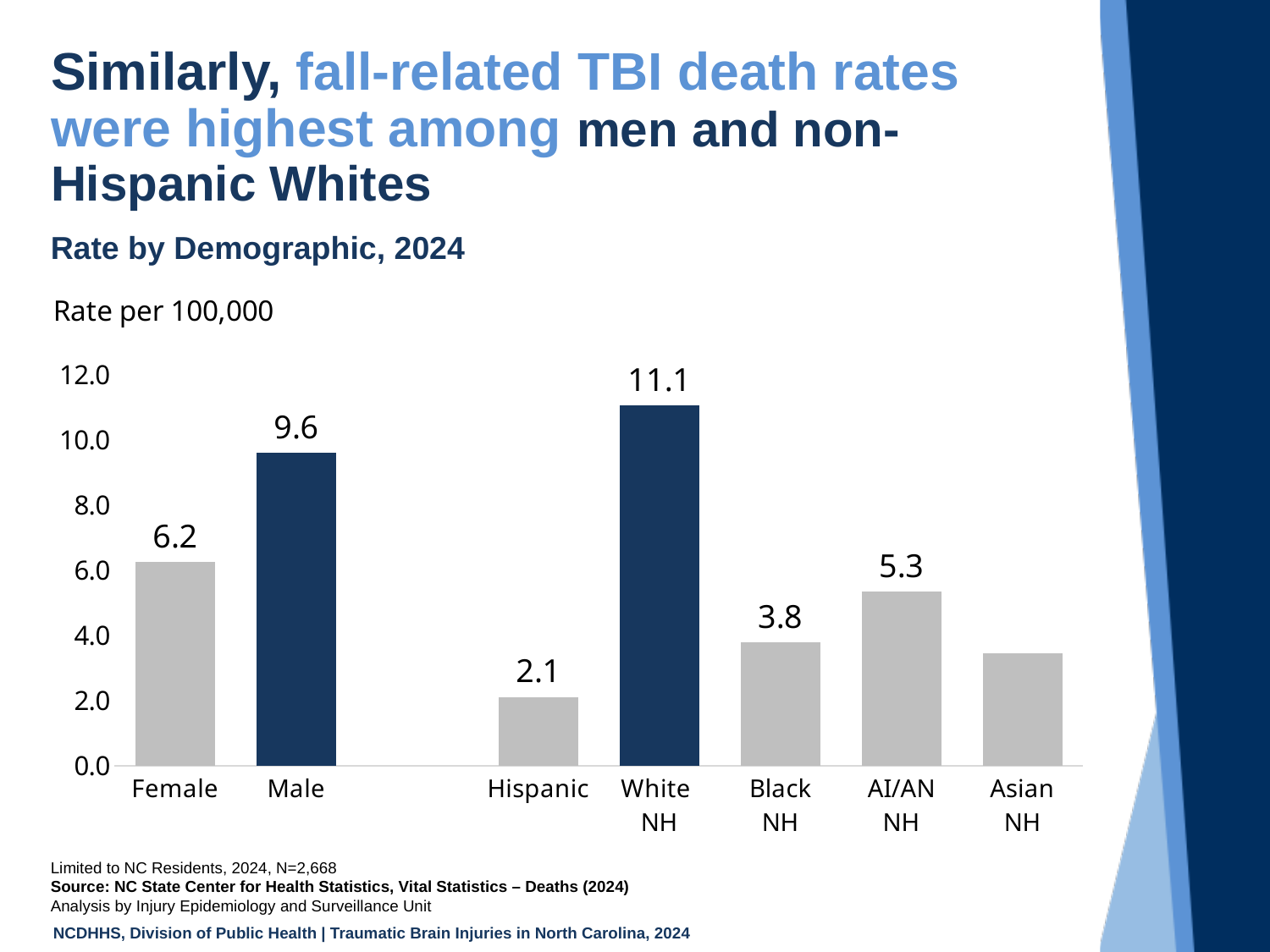
What is the difference between the Male and Female rates? 3.4 Which category has the lowest rate? Hispanic What is the rate for Hispanic? 2.1 Is the value for Asian NH greater or less than 4.0? less How many categories are shown on the x axis? 7 Which category has the highest rate? White NH Which is larger, the rate for Black NH or for AI/AN NH? AI/AN NH What is the rate for White NH? 11.1 What kind of chart is shown on the slide? bar chart What is the fall-related TBI death rate for Male? 9.6 What is the rate for AI/AN NH? 5.3 What unit is the y axis measured in, according to the label above the chart? Rate per 100,000